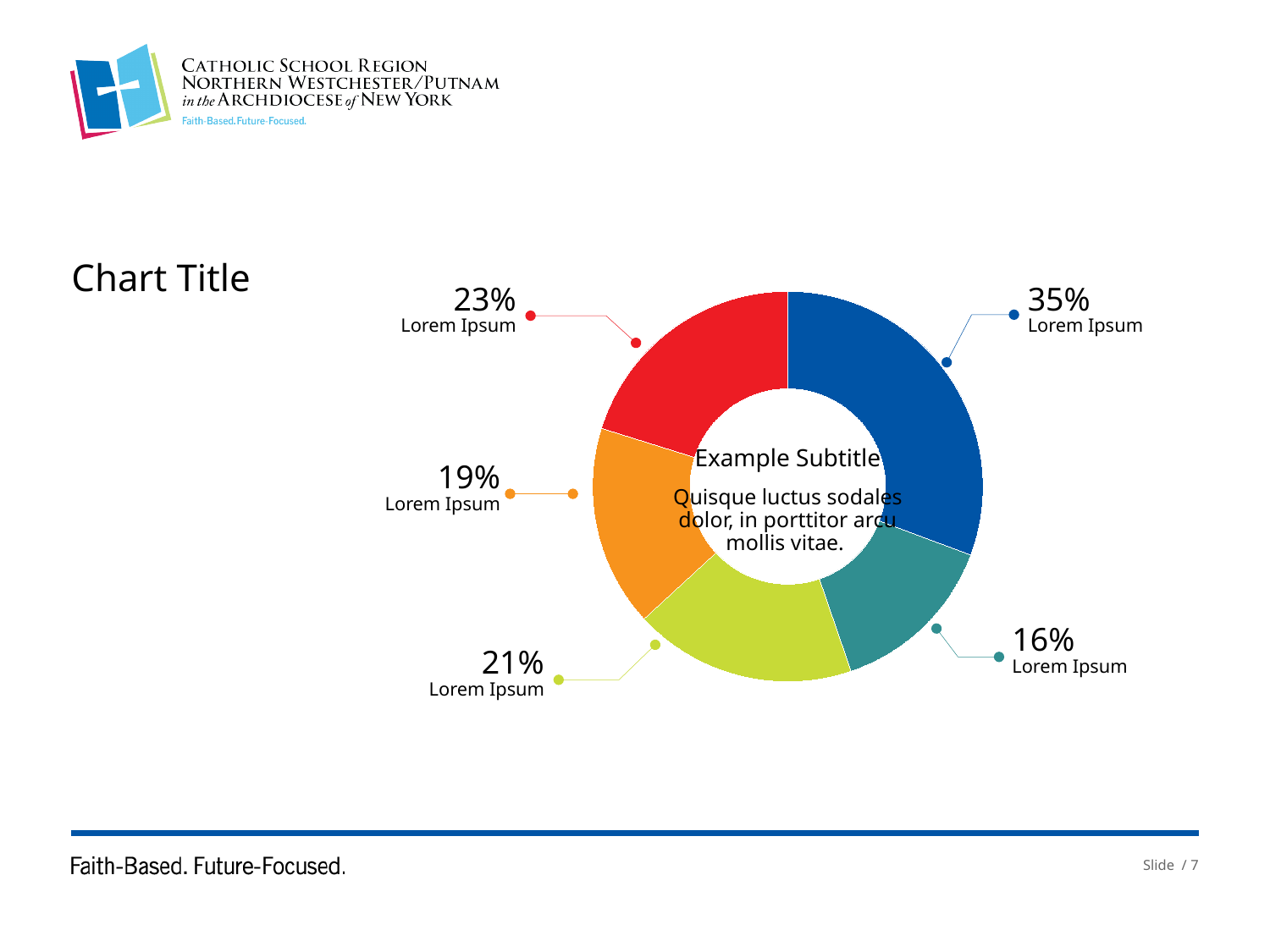
What text appears in the centre of the donut chart as its subtitle? Example Subtitle How many slices does the donut chart have? 5 What kind of chart is shown on the slide? Pie chart (donut) What percentage is shown for the lime green slice of the donut chart? 21% What is the smallest percentage shown on the donut chart? 16% What percentage is shown for the teal slice of the donut chart? 16% Which slice is larger, the red slice or the lime green slice? The red slice What percentage is shown for the dark blue slice of the donut chart? 35% What is the difference in percentage points between the dark blue slice and the teal slice? 19 What percentage is shown for the orange slice of the donut chart? 19% What percentage is shown for the red slice of the donut chart? 23% What is the largest percentage shown on the donut chart? 35%